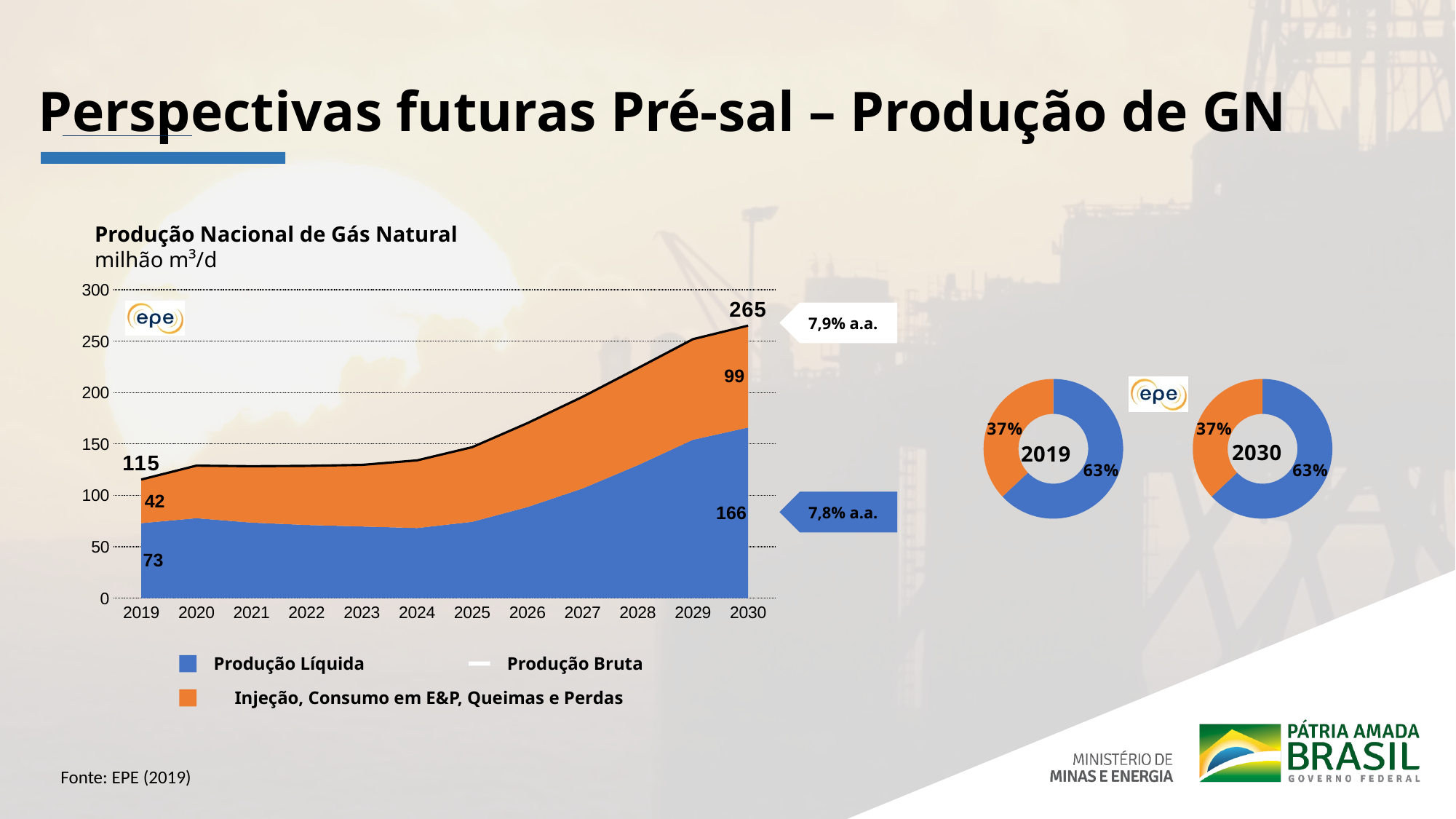
In the 2019 donut chart on the right, what share does the orange slice represent? 37% In the 'Produção Nacional de Gás Natural' chart, is the Produção Bruta in 2025 greater or less than 200? less In the 'Produção Nacional de Gás Natural' chart, what is the total Produção Bruta in 2030? 265 In the 'Produção Nacional de Gás Natural' chart, what is the total Produção Bruta in 2019? 115 In the 'Produção Nacional de Gás Natural' chart, what is the value of 'Injeção, Consumo em E&P, Queimas e Perdas' in 2030? 99 In the 2030 donut chart on the right, what share does the blue slice represent? 63% In the 'Produção Nacional de Gás Natural' chart, what is the value of Produção Líquida in 2019? 73 In the 'Produção Nacional de Gás Natural' chart, what is the value of Produção Líquida in 2030? 166 What type of chart is the 'Produção Nacional de Gás Natural' chart? stacked area chart In the 'Produção Nacional de Gás Natural' chart, how many years are shown on the x axis? 12 In the 'Produção Nacional de Gás Natural' chart, by how much does Produção Líquida increase from 2019 to 2030? 93 In the 'Produção Nacional de Gás Natural' chart, does Produção Bruta rise or fall between 2024 and 2030? rise